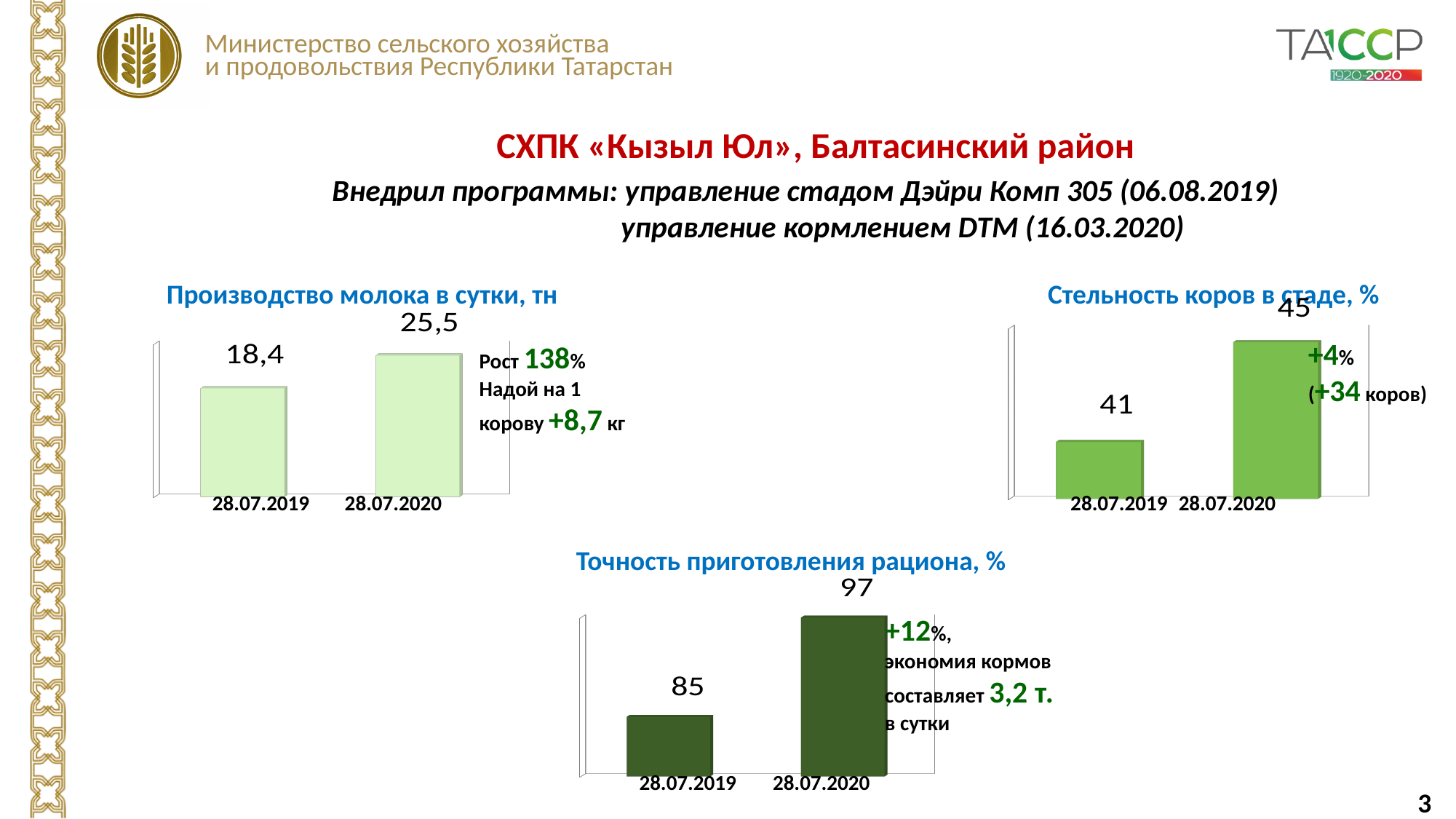
In the chart 'Стельность коров в стаде, %', what is the value for 28.07.2019? 41 What type of chart is 'Производство молока в сутки, тн'? Bar chart In the chart 'Производство молока в сутки, тн', do the values rise or fall from 28.07.2019 to 28.07.2020? Rise In the chart 'Производство молока в сутки, тн', what is the value for 28.07.2020? 25,5 In the chart 'Стельность коров в стаде, %', what is the difference between the 28.07.2020 and 28.07.2019 values? 4 In the chart 'Производство молока в сутки, тн', what is the difference between the 28.07.2020 and 28.07.2019 values? 7,1 In the chart 'Точность приготовления рациона, %', how many bars are plotted? 2 In the chart 'Производство молока в сутки, тн', what is the value for 28.07.2019? 18,4 In the chart 'Стельность коров в стаде, %', which date has the higher value? 28.07.2020 In the chart 'Точность приготовления рациона, %', what is the difference between the 28.07.2020 and 28.07.2019 values? 12 In the chart 'Точность приготовления рациона, %', what is the value for 28.07.2019? 85 In the chart 'Точность приготовления рациона, %', what is the value for 28.07.2020? 97